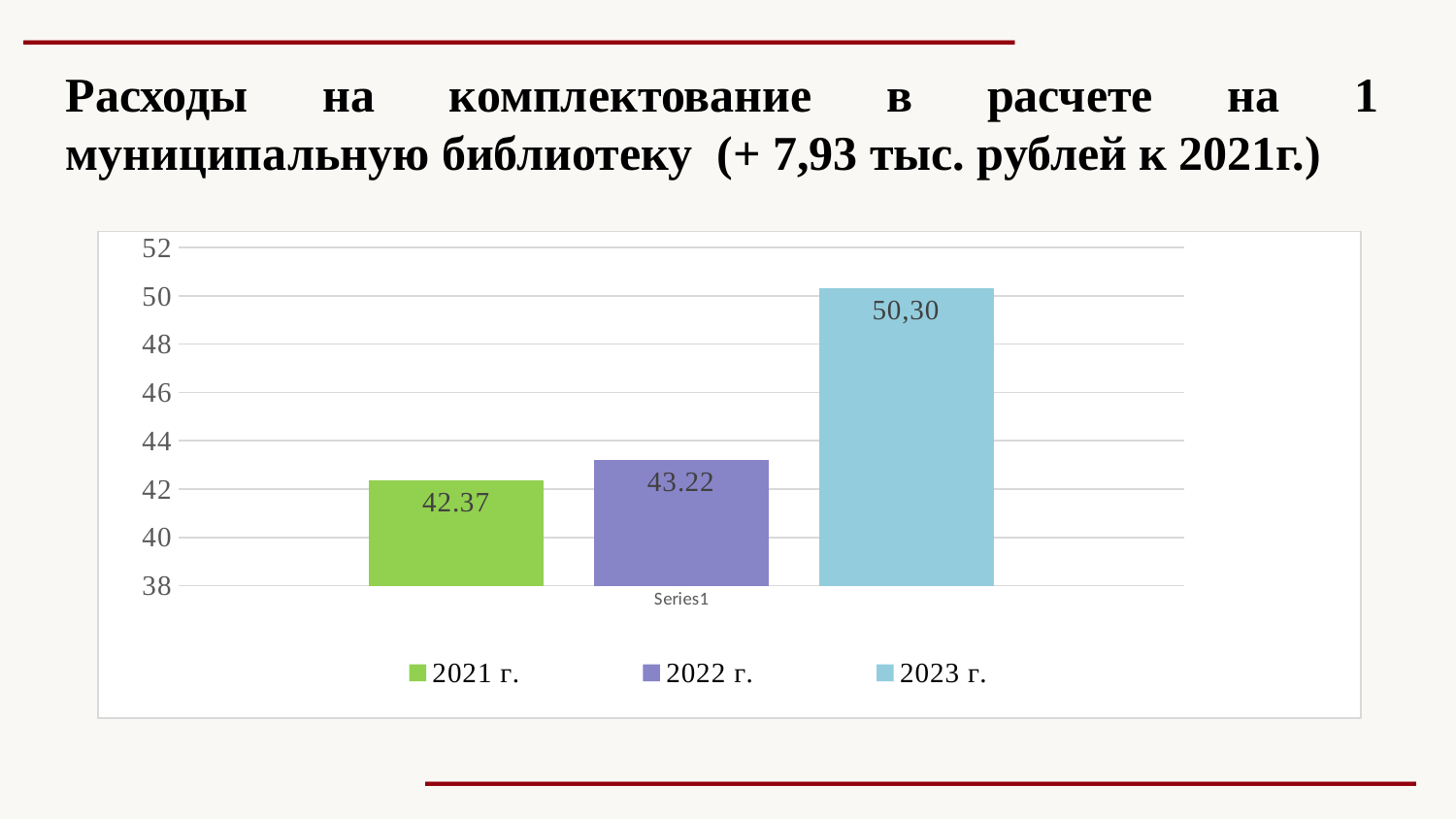
How many entries does the legend list? 3 Which year has the lowest value? 2021 г. What is the difference between the values for 2022 г. and 2021 г.? 0.85 What is the value for 2021 г.? 42.37 Which is larger, the value for 2022 г. or the value for 2023 г.? 2023 г. What is the difference between the values for 2023 г. and 2021 г.? 7.93 Is the value for 2023 г. greater or less than 48? greater How many bars are shown in the chart? 3 What is the value for 2022 г.? 43.22 What kind of chart is shown on the slide? bar chart Which year has the highest value? 2023 г. What is the value for 2023 г.? 50,30